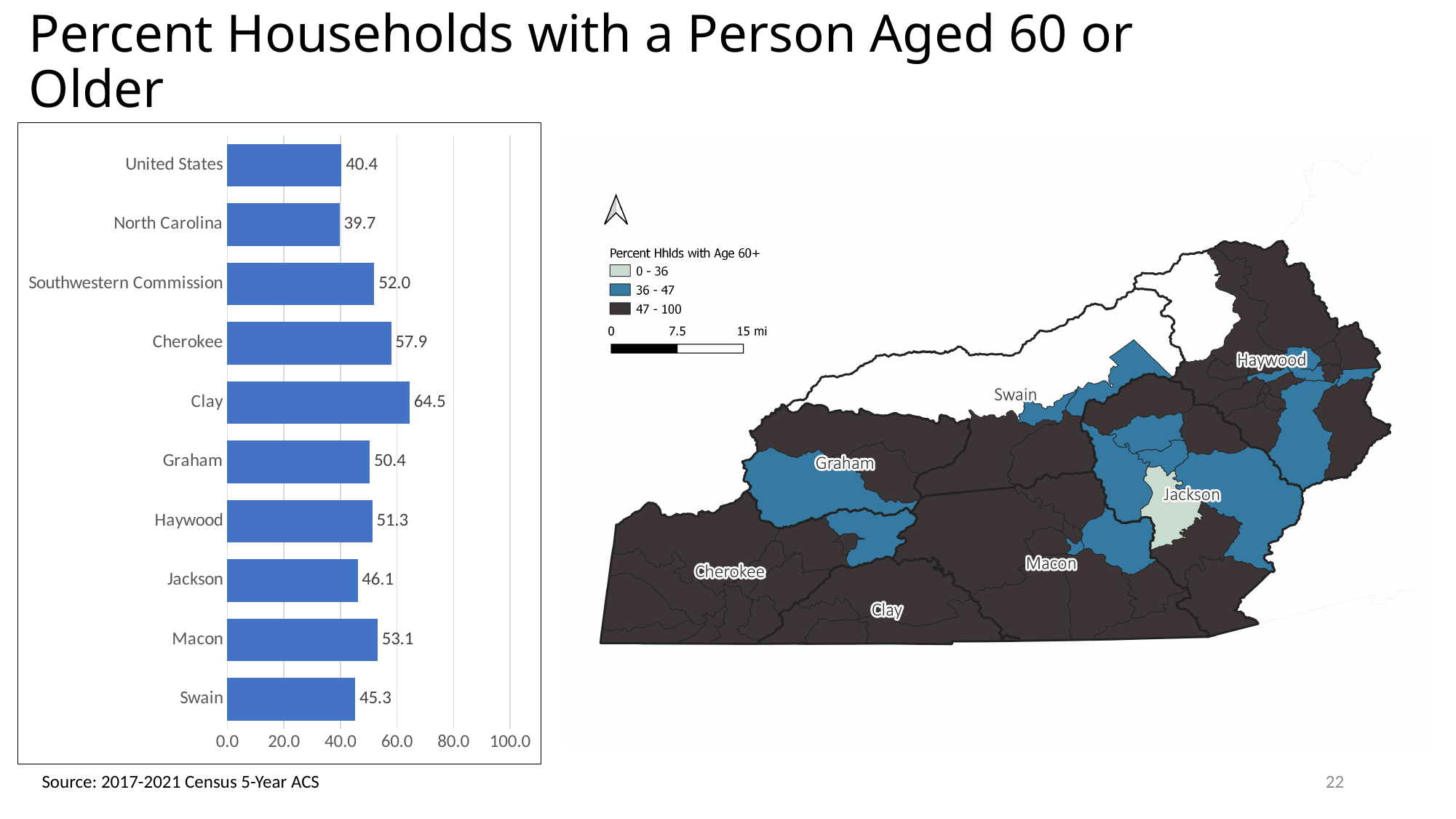
What is the value for North Carolina in the bar chart? 39.7 What is the value for Clay in the bar chart? 64.5 What is the difference between the values for United States and North Carolina in the bar chart? 0.7 What is the difference between the values for Clay and Jackson in the bar chart? 18.4 What is the value for Southwestern Commission in the bar chart? 52.0 Which category has the highest value in the bar chart? Clay Which is larger in the bar chart, Cherokee or Macon? Cherokee What kind of chart is shown on the left of the slide? bar chart Which category has the lowest value in the bar chart? North Carolina What is the title of the slide? Percent Households with a Person Aged 60 or Older Is the value for Swain in the bar chart greater or less than 60.0? less How many categories are shown in the bar chart? 10